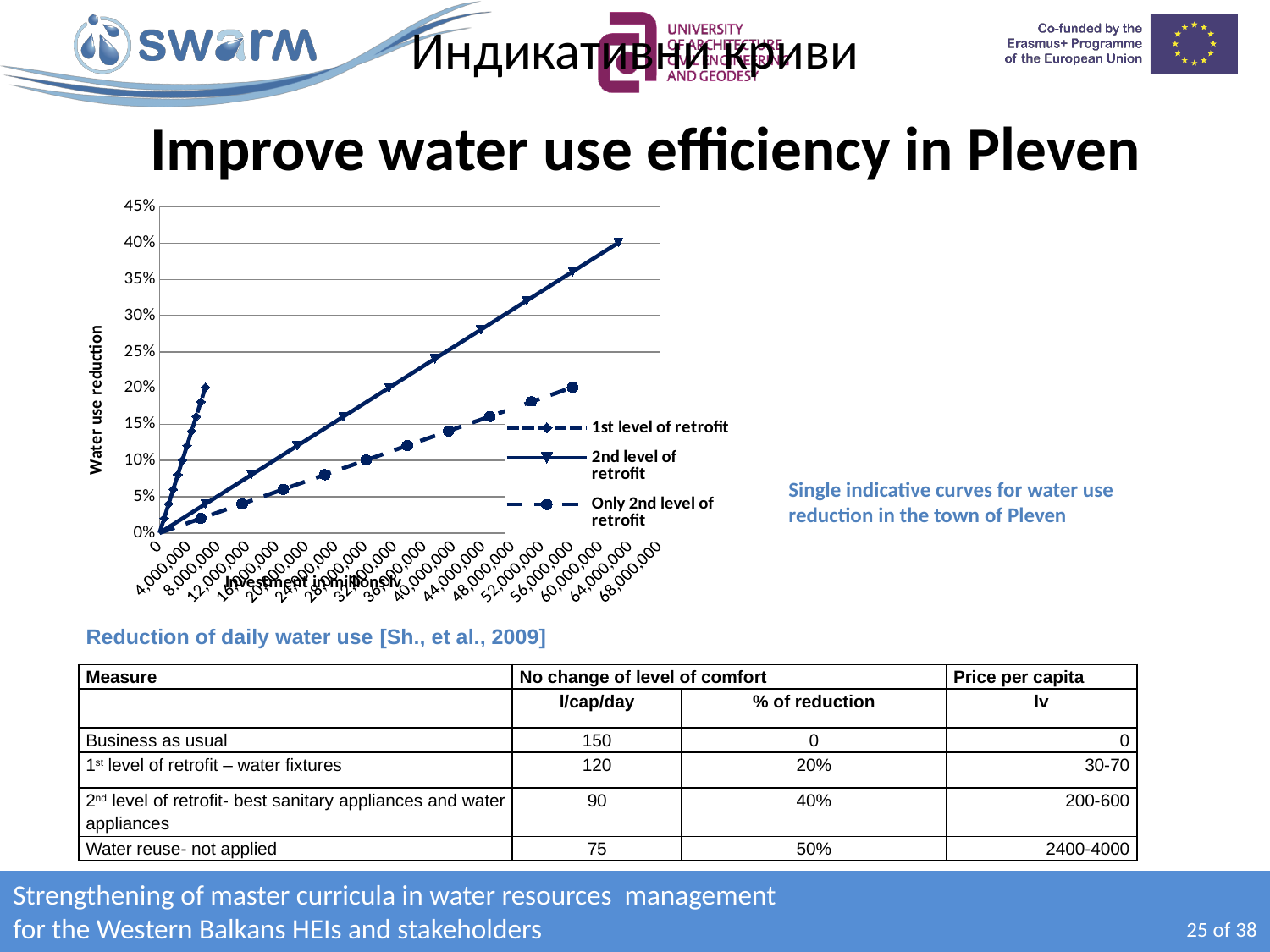
What is the highest tick value shown on the vertical axis of the chart? 45% Is the highest value reached by the 2nd level of retrofit line greater or less than 35%? greater Which series reaches its maximum water use reduction at the smallest investment: 1st level of retrofit or Only 2nd level of retrofit? 1st level of retrofit What is the title of the horizontal axis of the chart? Investment in millions lv Is the highest value reached by the Only 2nd level of retrofit line greater or less than 25%? less What kind of chart is shown on the slide? line chart At an investment of 40,000,000, is the value of the 2nd level of retrofit line greater or less than 30%? less What is the title of the vertical axis of the chart? Water use reduction Does the water use reduction for the 2nd level of retrofit rise or fall as investment increases? rise How many series does the chart legend list? 3 Which series reaches the highest water use reduction on the chart? 2nd level of retrofit